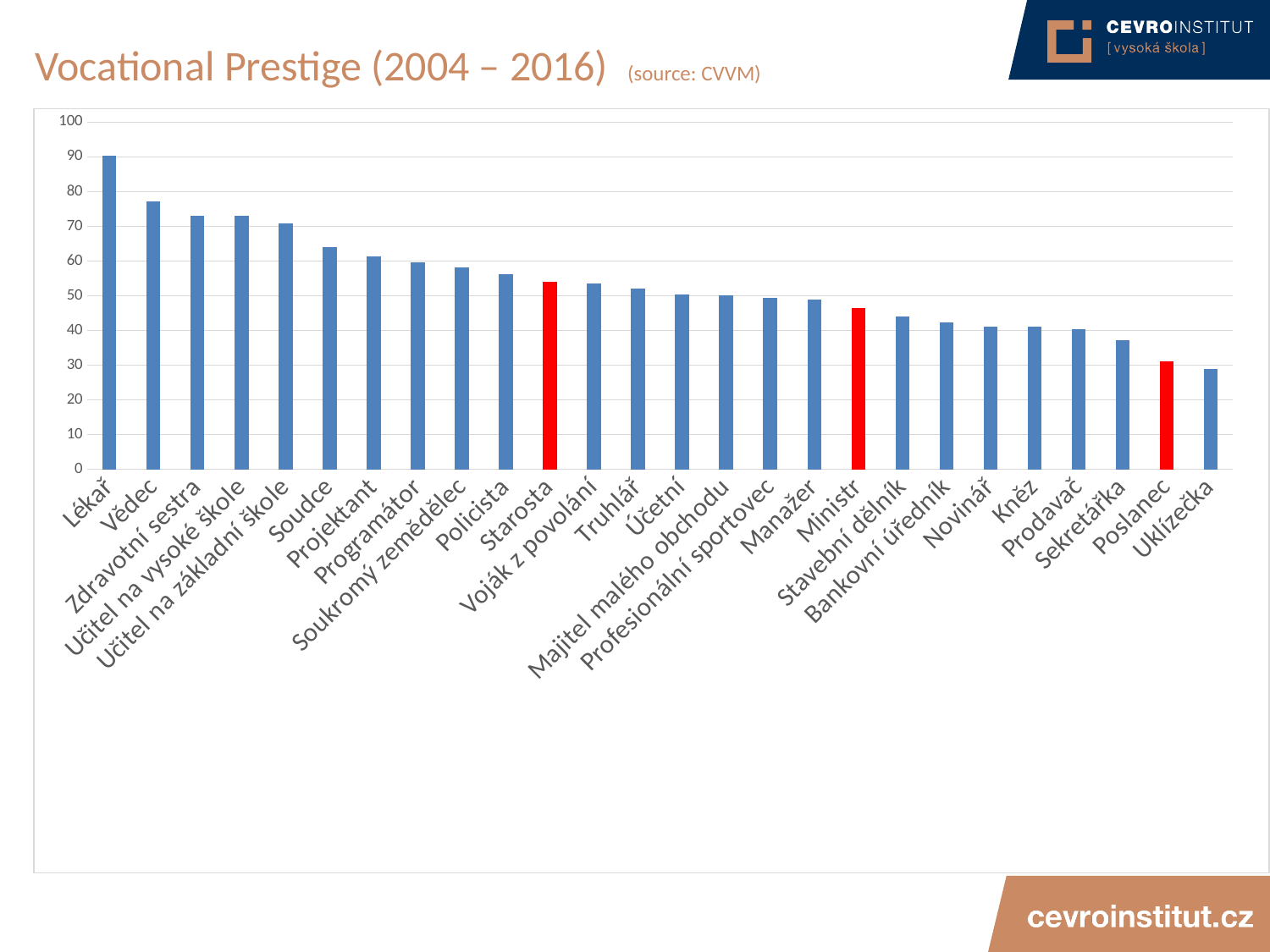
How many occupations are plotted on the chart? 26 Is the value for Poslanec greater or less than 40? less Which occupation has the lowest vocational prestige value? Uklízečka Is the value for Lékař greater or less than 80? greater Do the values rise or fall moving from left to right along the x axis? fall Which has the larger value, Starosta or Poslanec? Starosta What kind of chart is shown on the slide? bar chart Which occupation has the highest vocational prestige value? Lékař How many bars are coloured red on the chart? 3 What is the title of the chart on the slide? Vocational Prestige (2004 – 2016) Is the value for Ministr greater or less than 50? less